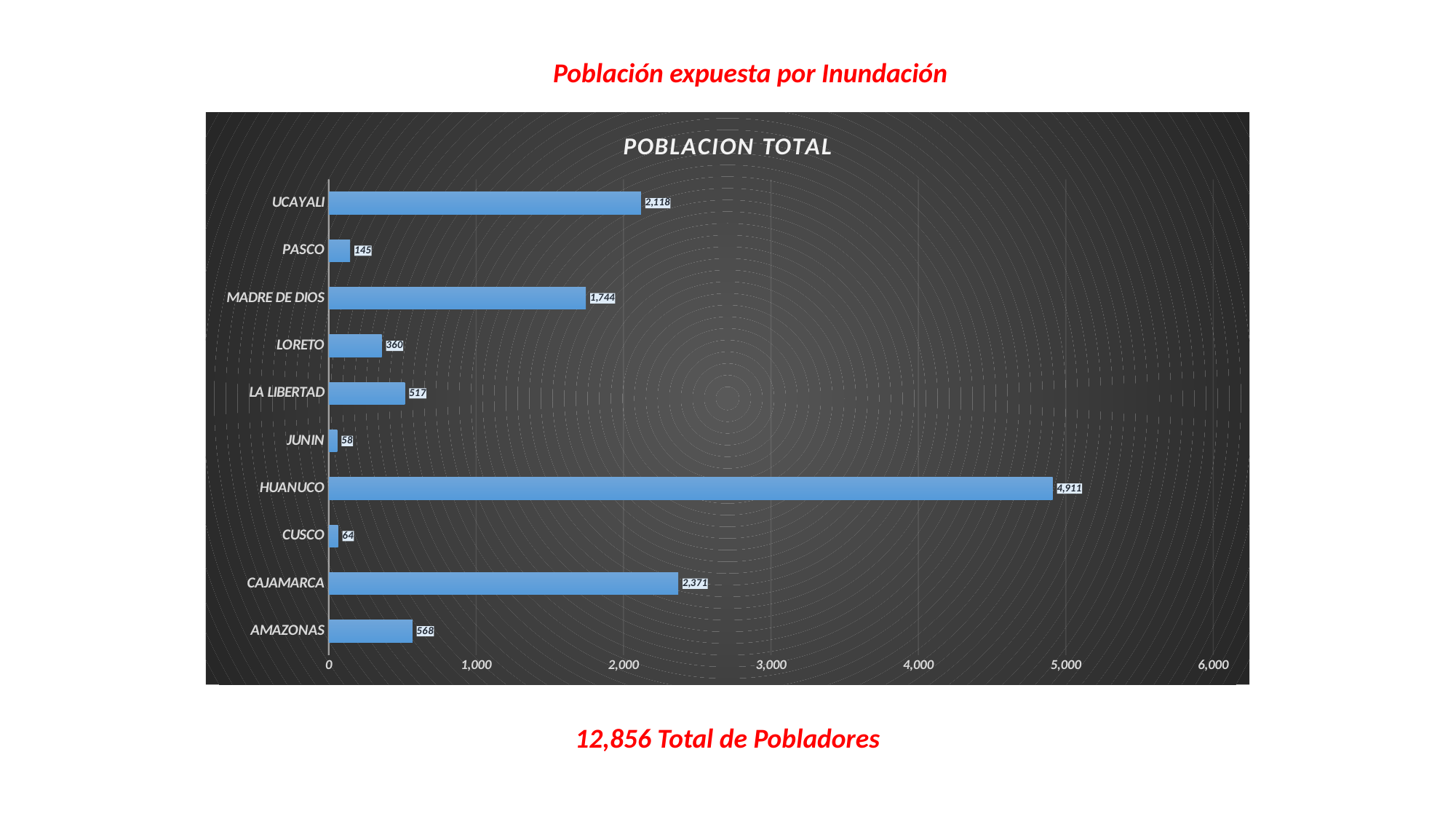
Which category has the highest value? HUANUCO What kind of chart is shown? bar chart Which is larger, the value for LA LIBERTAD or the value for LORETO? LA LIBERTAD What is the value for PASCO? 145 What is the title of the chart? POBLACION TOTAL Which category has the lowest value? JUNIN How many categories are shown in the chart? 10 What is the difference between the values for CAJAMARCA and UCAYALI? 253 What is the value for CAJAMARCA? 2,371 Is the value for UCAYALI greater or less than 2,000? greater What is the value for MADRE DE DIOS? 1,744 What is the value for HUANUCO? 4,911